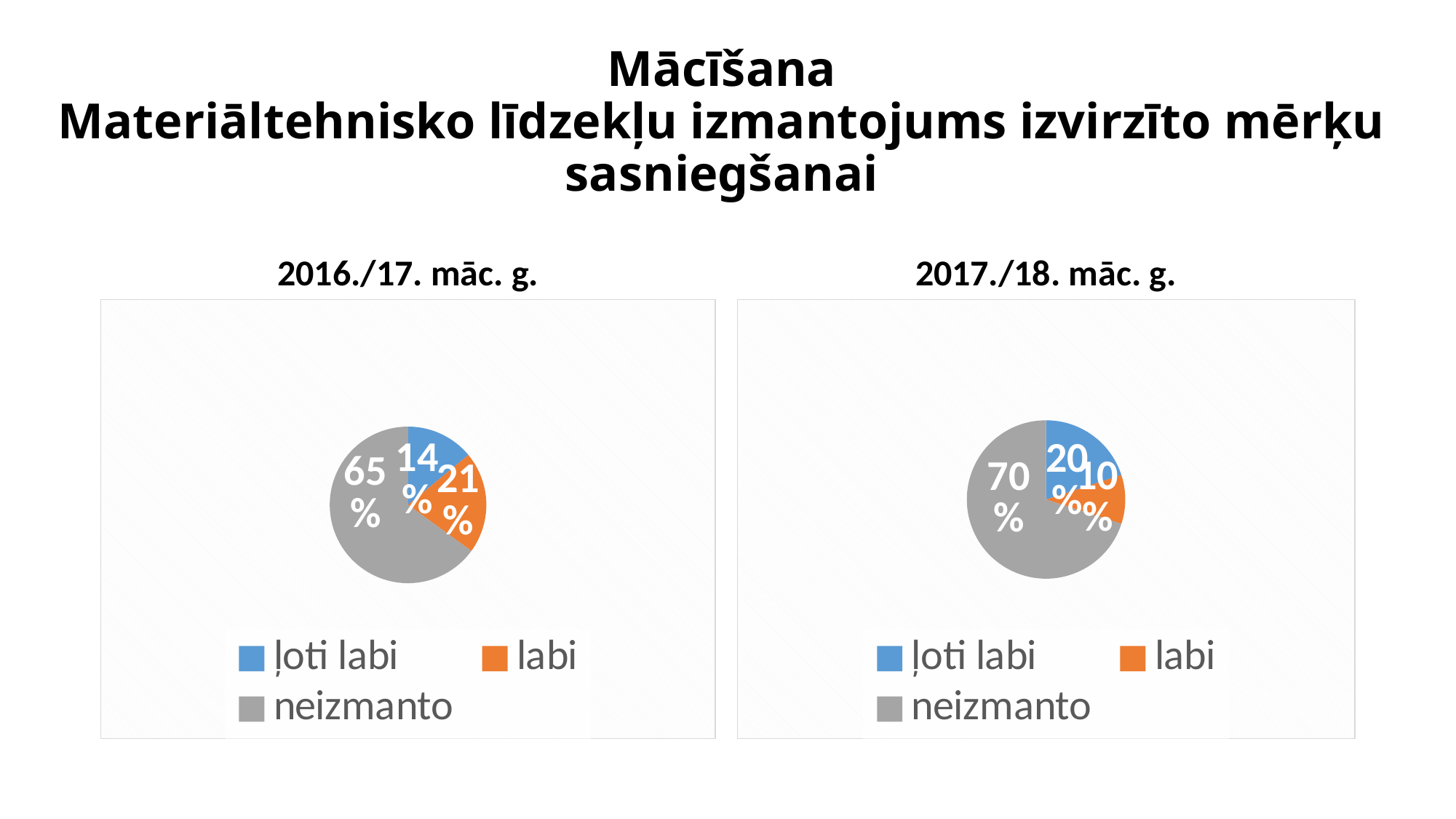
In the 2017./18. māc. g. pie chart, what share is labelled for 'ļoti labi'? 20% In the 2016./17. māc. g. pie chart, what is the difference between the 'labi' and 'ļoti labi' shares? 7% How many categories does the legend of the 2016./17. māc. g. chart list? 3 In the 2016./17. māc. g. pie chart, what share is labelled for 'ļoti labi'? 14% In the 2017./18. māc. g. pie chart, what share is labelled for 'neizmanto'? 70% In the 2016./17. māc. g. pie chart, what share is labelled for 'neizmanto'? 65% In the 2017./18. māc. g. pie chart, which category has the smallest slice? labi In the 2016./17. māc. g. pie chart, what share is labelled for 'labi'? 21% In the 2016./17. māc. g. pie chart, which category has the largest slice? neizmanto In the 2017./18. māc. g. pie chart, what share is labelled for 'labi'? 10% What type of chart is shown for 2017./18. māc. g.? pie chart In the 2017./18. māc. g. pie chart, which is larger: 'ļoti labi' or 'labi'? ļoti labi